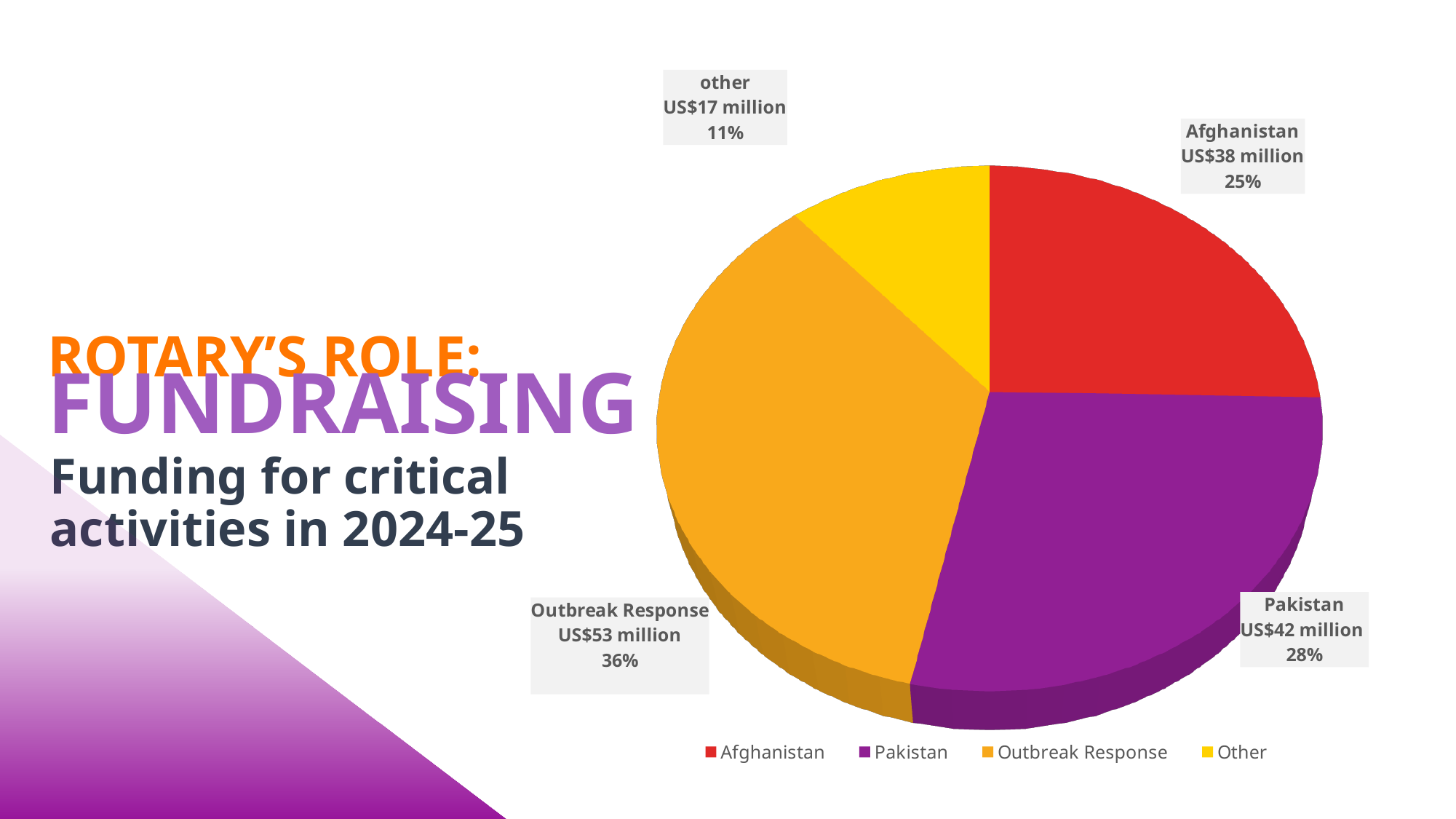
Which receives more funding, Outbreak Response or Pakistan? Outbreak Response How much funding is shown for Afghanistan? US$38 million Which category receives the smallest share of funding? Other How much funding is shown for Outbreak Response? US$53 million What percentage of the pie does the Other slice represent? 11% How many entries does the legend list? 4 What is the difference in funding between Pakistan and Afghanistan? US$4 million Which category receives the largest share of funding? Outbreak Response What percentage of the pie does Pakistan represent? 28% What kind of chart is shown on the slide? Pie chart How many slices does the pie chart have? 4 What colour is the Pakistan slice? Purple